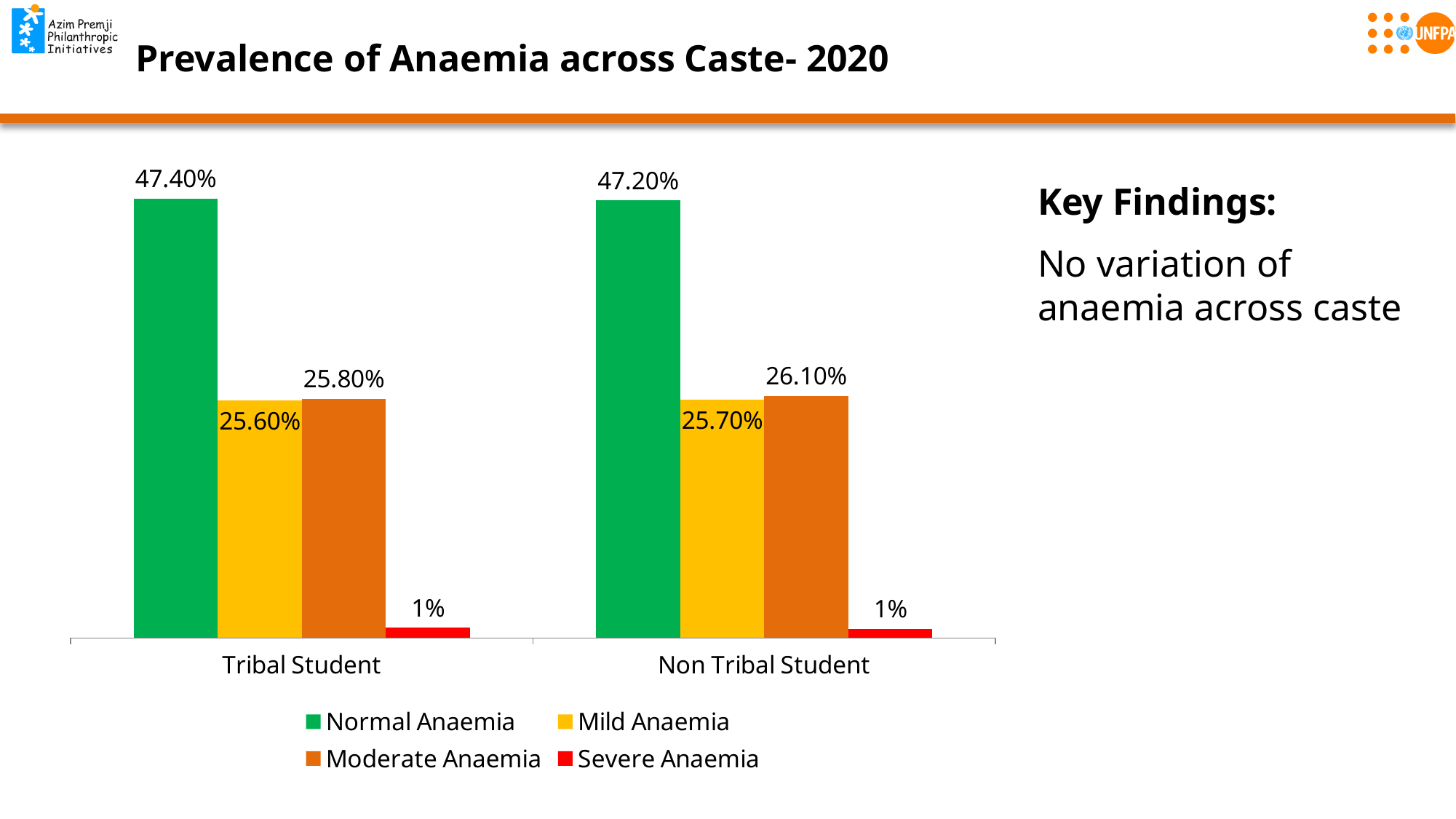
What is the value for Severe Anaemia among Non Tribal Students? 1% What is the value for Mild Anaemia among Tribal Students? 25.60% How many series does the legend list? 4 What kind of chart is shown on the slide? Bar chart What is the value for Normal Anaemia among Tribal Students? 47.40% Which is larger: Normal Anaemia among Tribal Students or Moderate Anaemia among Tribal Students? Normal Anaemia among Tribal Students What is the value for Moderate Anaemia among Non Tribal Students? 26.10% Which anaemia category has the highest value among Non Tribal Students? Normal Anaemia What is the difference between Normal Anaemia for Tribal Students and Non Tribal Students? 0.20% How many student categories are shown on the x axis? 2 What is the difference between Moderate Anaemia and Mild Anaemia among Non Tribal Students? 0.40% Which anaemia category has the lowest value among Tribal Students? Severe Anaemia